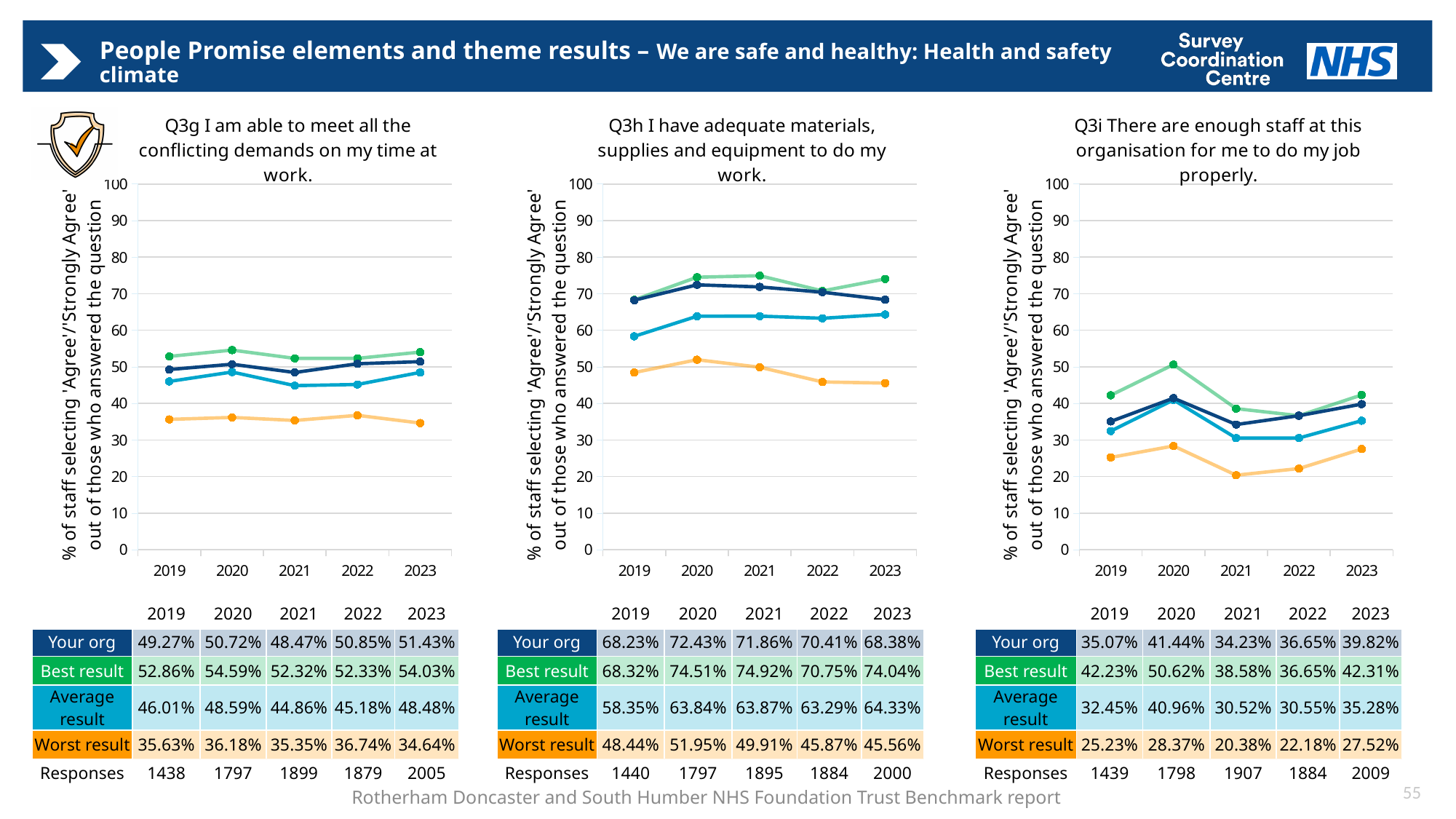
In the Q3g chart, what is the difference between the 'Best result' and 'Your org' values in 2023? 2.60 percentage points In the Q3i chart, by how much did the 'Your org' value change from 2019 to 2020? 6.37 percentage points How many years are shown on the x axis of each chart? 5 In the Q3i chart, in which year is the 'Your org' value highest? 2020 In the Q3g chart, in which year is the 'Worst result' value lowest? 2023 How many series are plotted in the Q3g chart? 4 In the Q3h chart (I have adequate materials, supplies and equipment to do my work), what is the 'Worst result' value for 2022? 45.87% What type of chart is used for the Q3h question? Line chart In the Q3h chart, does the 'Worst result' line rise or fall from 2020 to 2023? Fall In the Q3h chart, is the 'Your org' value higher in 2020 or in 2021? 2020 In the Q3g chart (I am able to meet all the conflicting demands on my time at work), what is the 'Your org' value for 2023? 51.43% In the Q3i chart (There are enough staff at this organisation for me to do my job properly), what is the 'Best result' value for 2020? 50.62%